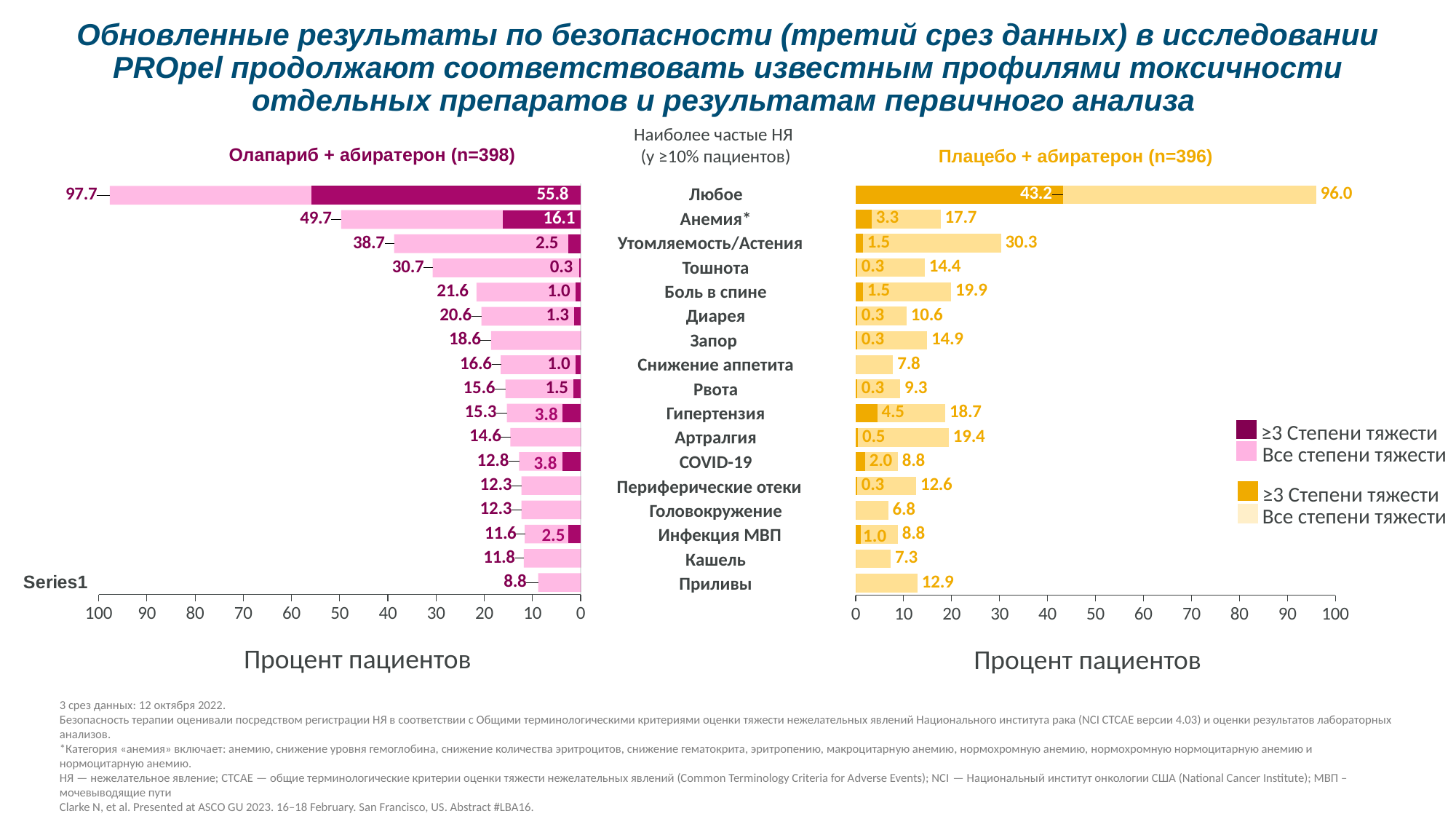
In the chart 'Плацебо + абиратерон (n=396)', is the 'Все степени тяжести' value for Гипертензия greater or less than 10? greater In the chart 'Олапариб + абиратерон (n=398)', what is the value for 'Все степени тяжести' for Анемия*? 49.7 In the chart 'Плацебо + абиратерон (n=396)', which category has the highest value for 'Все степени тяжести'? Любое How many series does the legend list for the chart 'Олапариб + абиратерон (n=398)'? 2 What kind of chart is 'Плацебо + абиратерон (n=396)'? Bar chart In the chart 'Олапариб + абиратерон (n=398)', what is the difference between the 'Все степени тяжести' values for Любое and Анемия*? 48.0 In the chart 'Плацебо + абиратерон (n=396)', what is the value for '≥3 Степени тяжести' for Любое? 43.2 How many adverse event categories are listed on the slide's charts? 17 In the chart 'Плацебо + абиратерон (n=396)', what is the value for 'Все степени тяжести' for Утомляемость/Астения? 30.3 In the chart 'Олапариб + абиратерон (n=398)', which is larger for 'Все степени тяжести': Тошнота or Боль в спине? Тошнота In the chart 'Олапариб + абиратерон (n=398)', which category has the lowest value for 'Все степени тяжести'? Приливы In the chart 'Плацебо + абиратерон (n=396)', what is the difference between the 'Все степени тяжести' values for Боль в спине and Диарея? 9.3